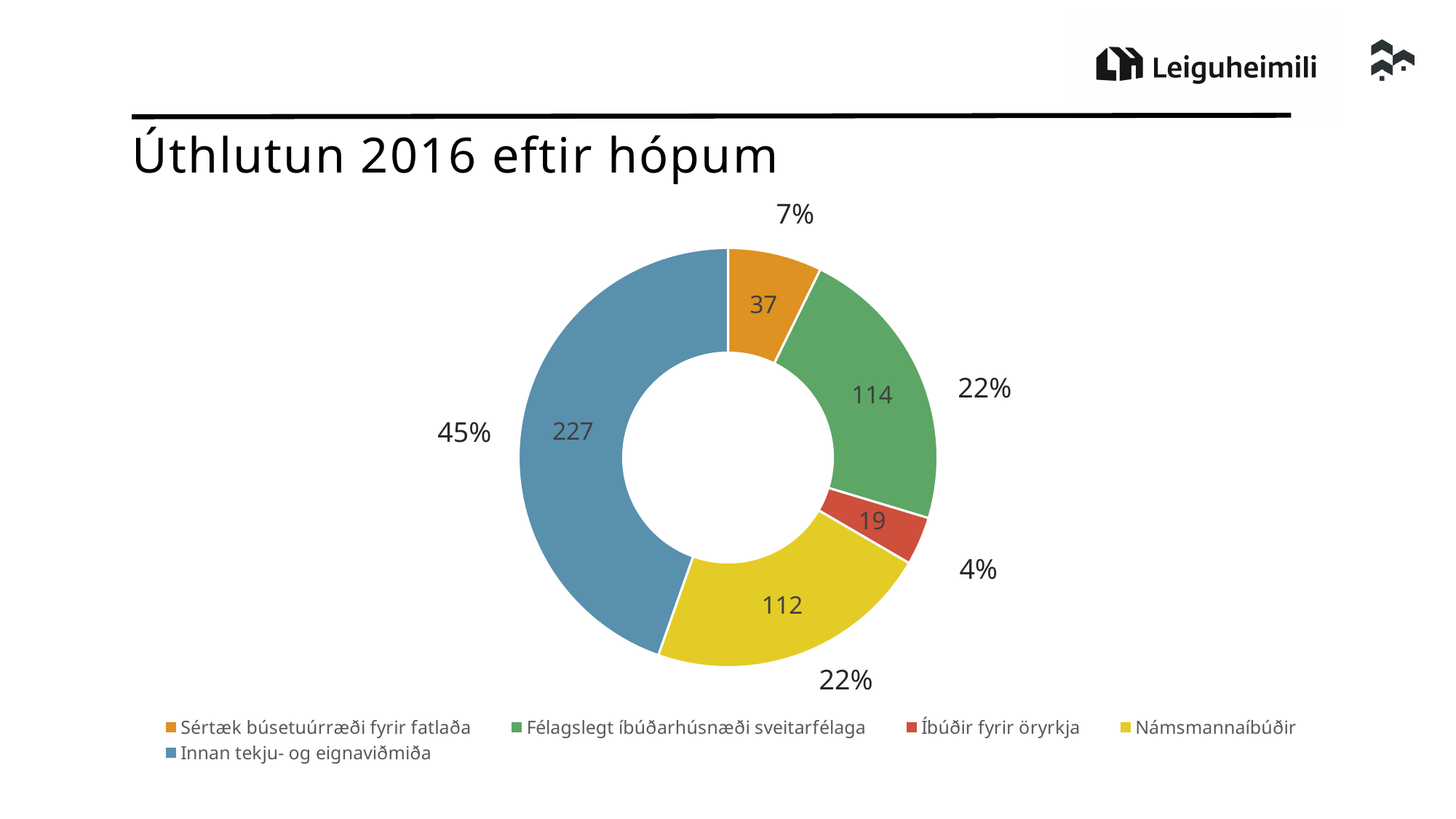
What is the value for Innan tekju- og eignaviðmiða? 227 What percentage share is shown for Sértæk búsetuúrræði fyrir fatlaða? 7% What is the value for Félagslegt íbúðarhúsnæði sveitarfélaga? 114 What is the title of the chart? Úthlutun 2016 eftir hópum What type of chart is shown on the slide? Doughnut chart What is the value for Íbúðir fyrir öryrkja? 19 How many categories does the chart show? 5 Which category has the smallest value? Íbúðir fyrir öryrkja What is the difference between the values for Innan tekju- og eignaviðmiða and Námsmannaíbúðir? 115 Which is larger, the value for Sértæk búsetuúrræði fyrir fatlaða or the value for Íbúðir fyrir öryrkja? Sértæk búsetuúrræði fyrir fatlaða What percentage share is shown for Innan tekju- og eignaviðmiða? 45% Which category has the largest value? Innan tekju- og eignaviðmiða